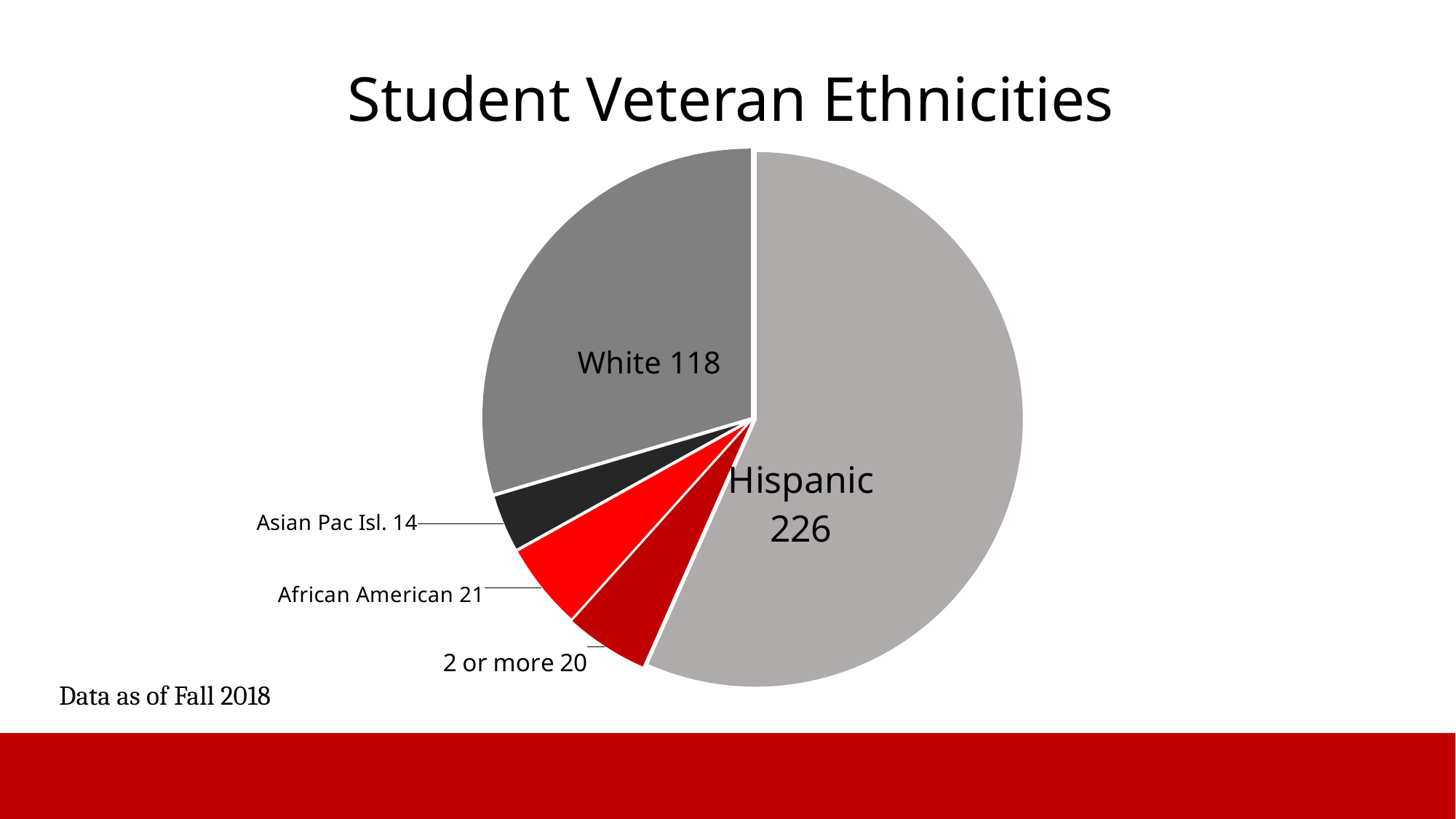
What is the value for African American? 21 How many categories are shown in the pie chart? 5 How many student veterans are Hispanic? 226 What is the total of all the slices in the pie chart? 399 Which ethnicity has the smallest slice of the pie? Asian Pac Isl. What is the title of the chart? Student Veteran Ethnicities What is the difference between the Hispanic and White values? 108 What is the value for Asian Pac Isl.? 14 Which is larger, the value for White or the value for 2 or more? White What type of chart is shown on the slide? pie chart Which ethnicity has the largest slice of the pie? Hispanic What is the value for White? 118